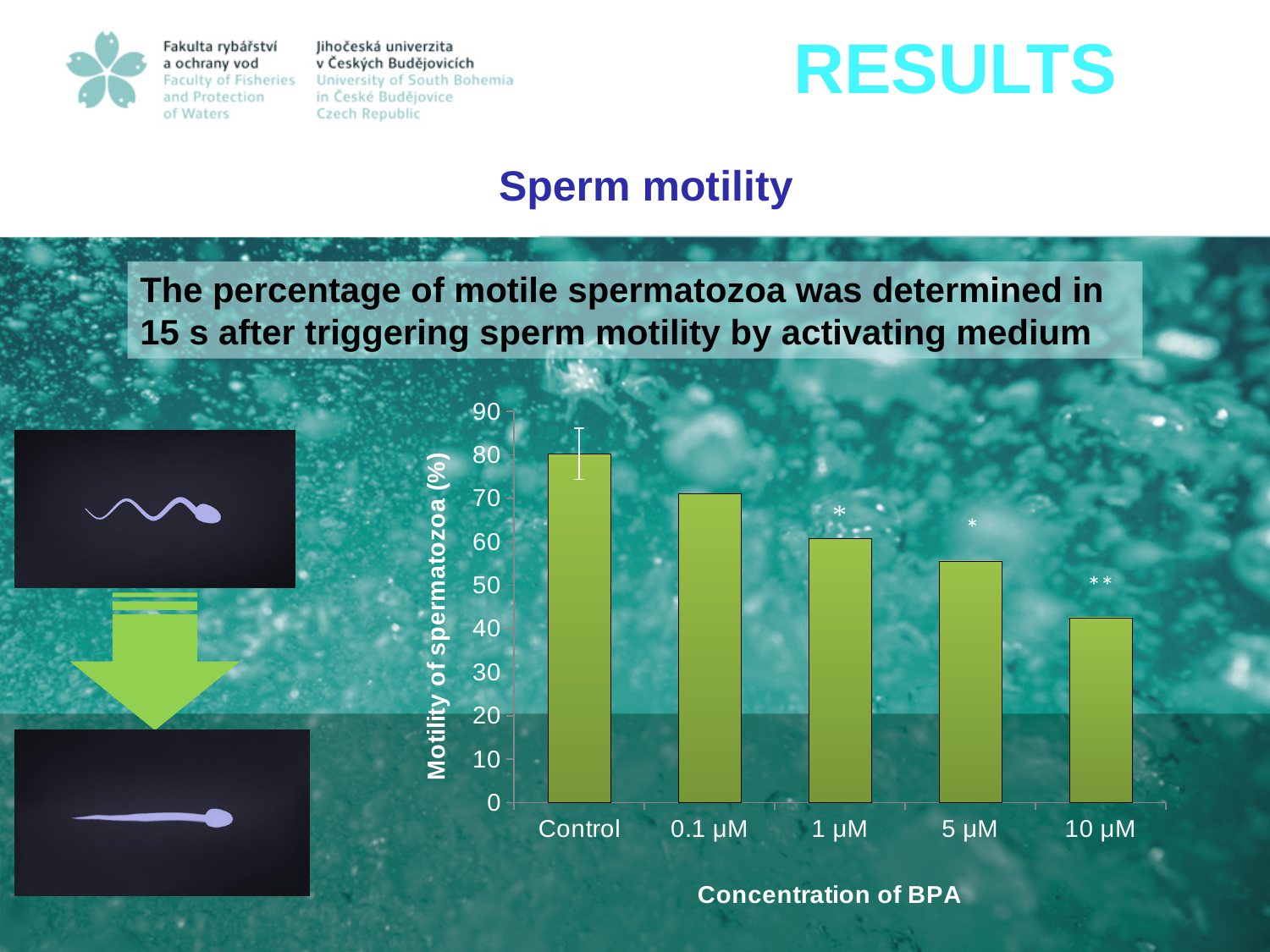
Is the motility value for 0.1 µM greater or less than 60? greater Is the motility value for 10 µM greater or less than 50? less Do the motility values rise or fall as the BPA concentration increases along the x axis? fall What is the label of the y axis of the chart? Motility of spermatozoa (%) Is the motility value for Control greater or less than 70? greater Which category has the highest motility of spermatozoa? Control What is the label of the x axis of the chart? Concentration of BPA What kind of chart is shown on the slide? bar chart Which has higher motility of spermatozoa, 1 µM or 5 µM? 1 µM Which BPA concentration has the lowest motility of spermatozoa? 10 µM How many concentration categories are shown on the x axis of the chart? 5